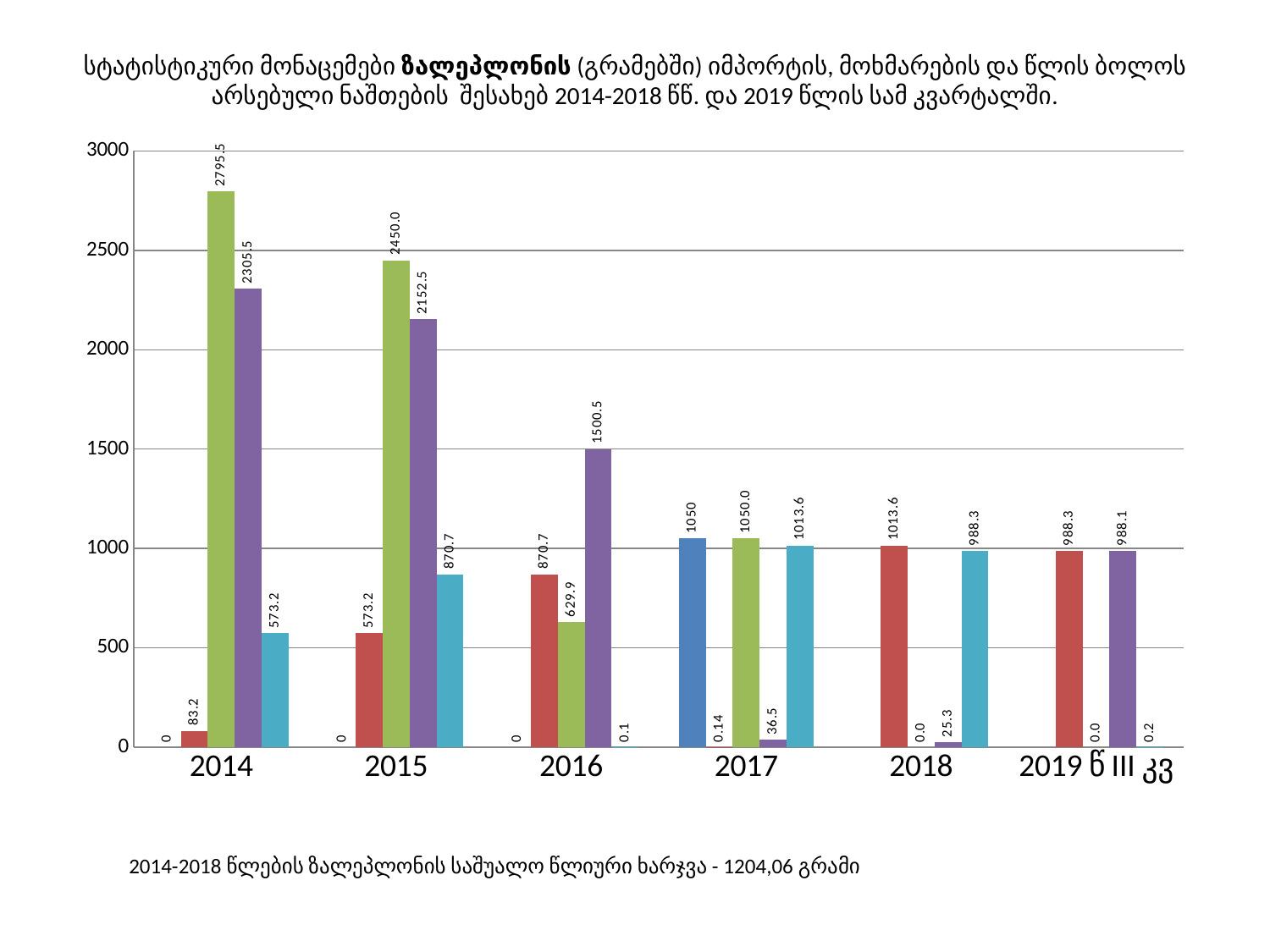
Which is larger, the purple bar for 2014 or the purple bar for 2015? purple bar for 2014 Which year has the tallest bar in the chart? 2014 What is the value of the red bar for 2017? 0.14 How many categories are shown along the x axis? 6 What is the value of the light blue bar for 2018? 988.3 What is the difference between the red bar for 2016 and the green bar for 2016? 240.8 What kind of chart is shown on the slide? bar chart What is the highest value shown on the y axis? 3000 What is the value of the purple bar for 2016? 1500.5 What is the difference between the green bar for 2014 and the green bar for 2015? 345.5 What is the value of the green bar for 2014? 2795.5 Do the green bars rise or fall from 2014 to 2016? fall